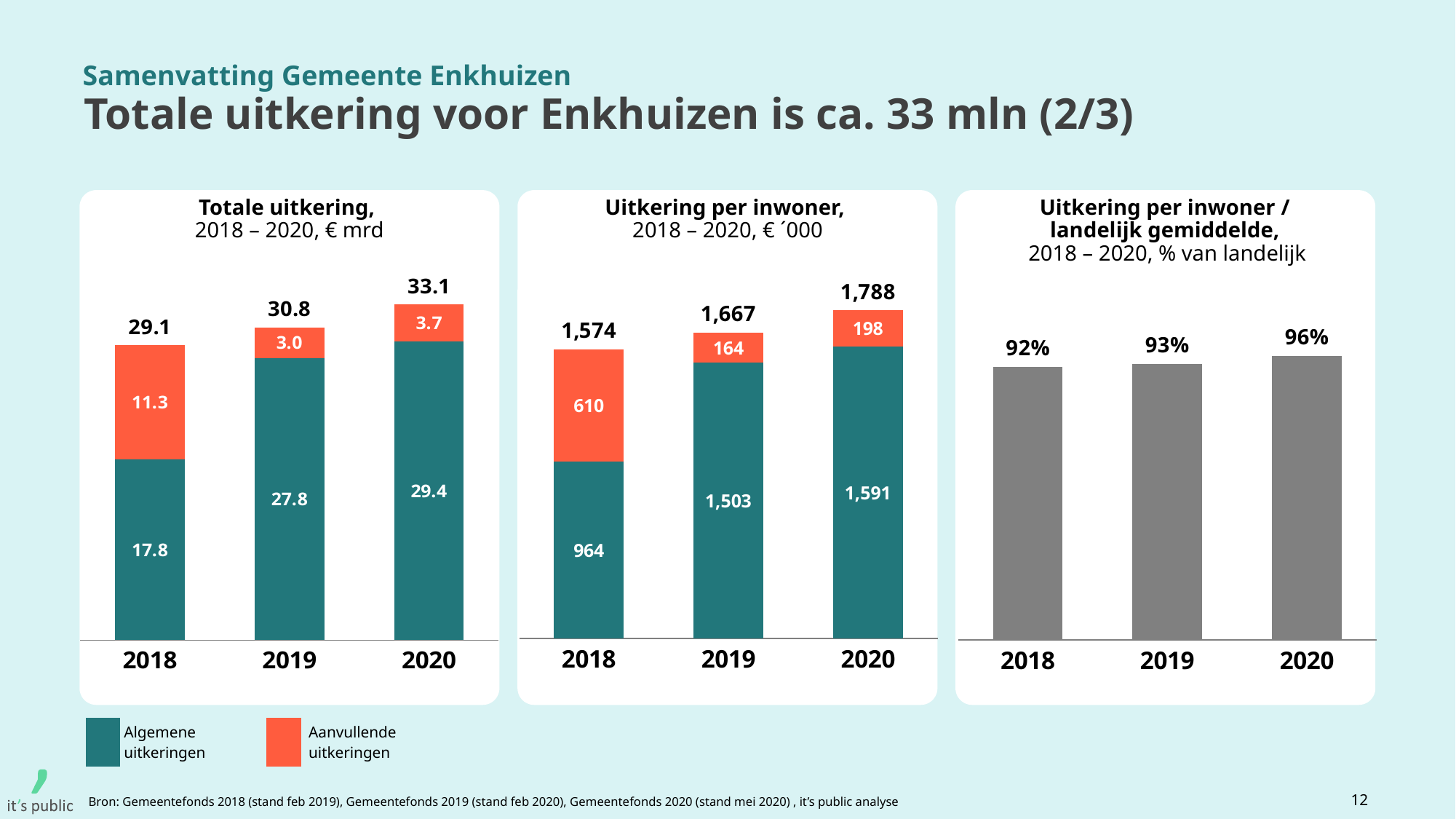
In the 'Uitkering per inwoner / landelijk gemiddelde' chart, what is the value for 2019? 93% In the 'Uitkering per inwoner' chart, what is the value of Algemene uitkeringen for 2019? 1,503 In the 'Uitkering per inwoner / landelijk gemiddelde' chart, do the values rise or fall from 2018 to 2020? rise In the 'Totale uitkering' chart, what is the value of Algemene uitkeringen for 2018? 17.8 In the 'Totale uitkering' chart, which year has the lowest total? 2018 In the 'Uitkering per inwoner' chart, what is the total for 2020? 1,788 In the 'Uitkering per inwoner' chart, what is the difference between the Aanvullende uitkeringen values for 2018 and 2020? 412 In the 'Totale uitkering' chart, what is the total of the stacked bar for 2020? 33.1 What kind of chart is the 'Totale uitkering' chart? stacked bar chart How many series does the legend at the bottom of the slide list? 2 In the 'Uitkering per inwoner / landelijk gemiddelde' chart, which year has the highest value? 2020 In the 'Totale uitkering' chart, what is the value of Aanvullende uitkeringen for 2019? 3.0